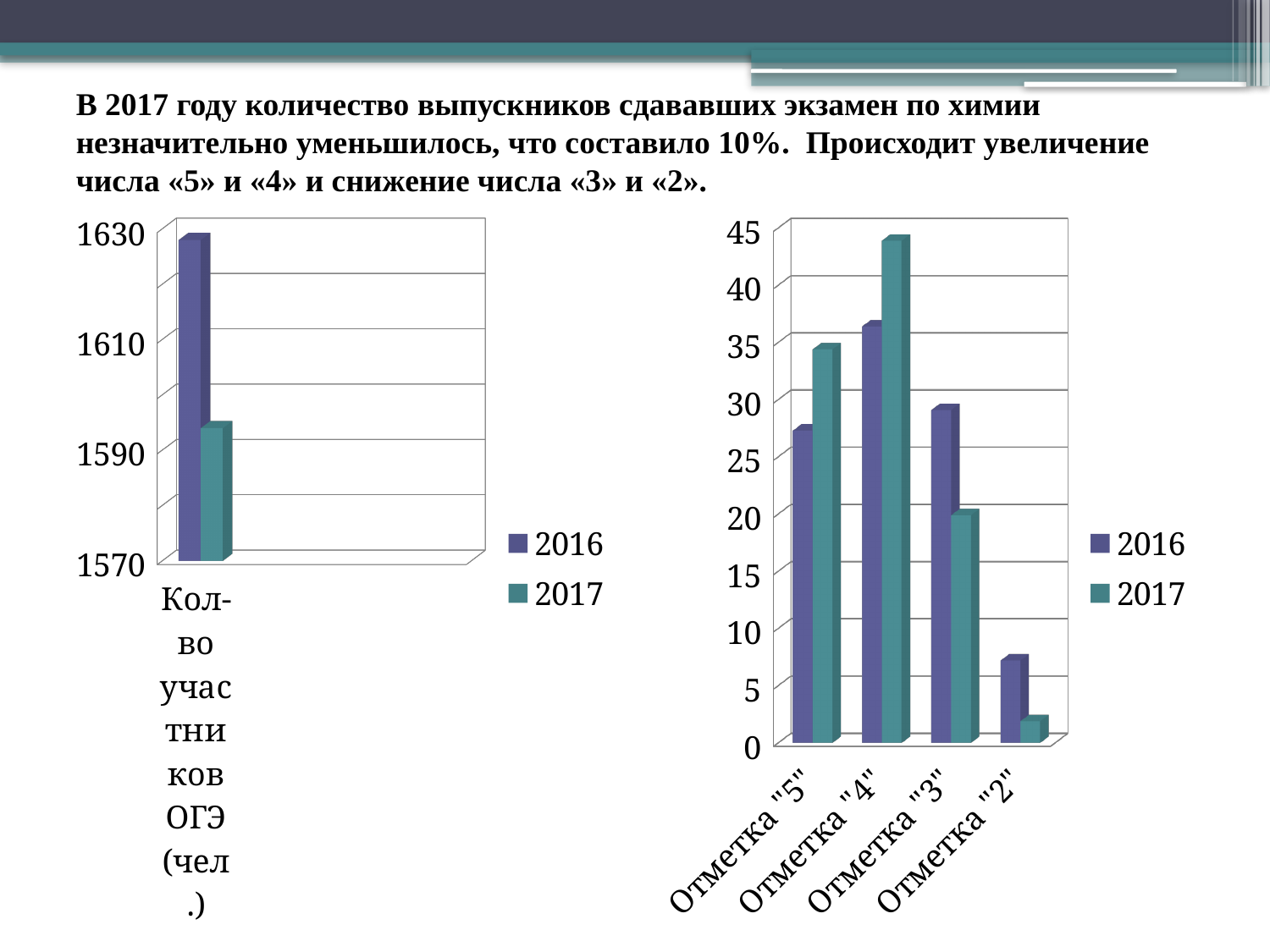
In the right chart, which category has the tallest bar overall? Отметка "4" (2017) In the left chart, which is larger: the 2016 bar or the 2017 bar? 2016 In the left chart, is the 2016 value for Кол-во участников ОГЭ greater or less than 1610? greater In the right chart, which is larger for Отметка "3": the 2016 value or the 2017 value? 2016 In the right chart, is the 2016 value for Отметка "2" greater or less than 10? less How many series does the legend of the right chart list? 2 In the right chart, which category has the shortest bar overall? Отметка "2" (2017) In the right chart, do the 2016 values rise or fall moving from Отметка "4" to Отметка "2"? fall In the right chart, is the 2017 value for Отметка "4" greater or less than 40? greater What kind of chart is the chart on the right of the slide? bar chart How many categories are shown on the x axis of the right chart? 4